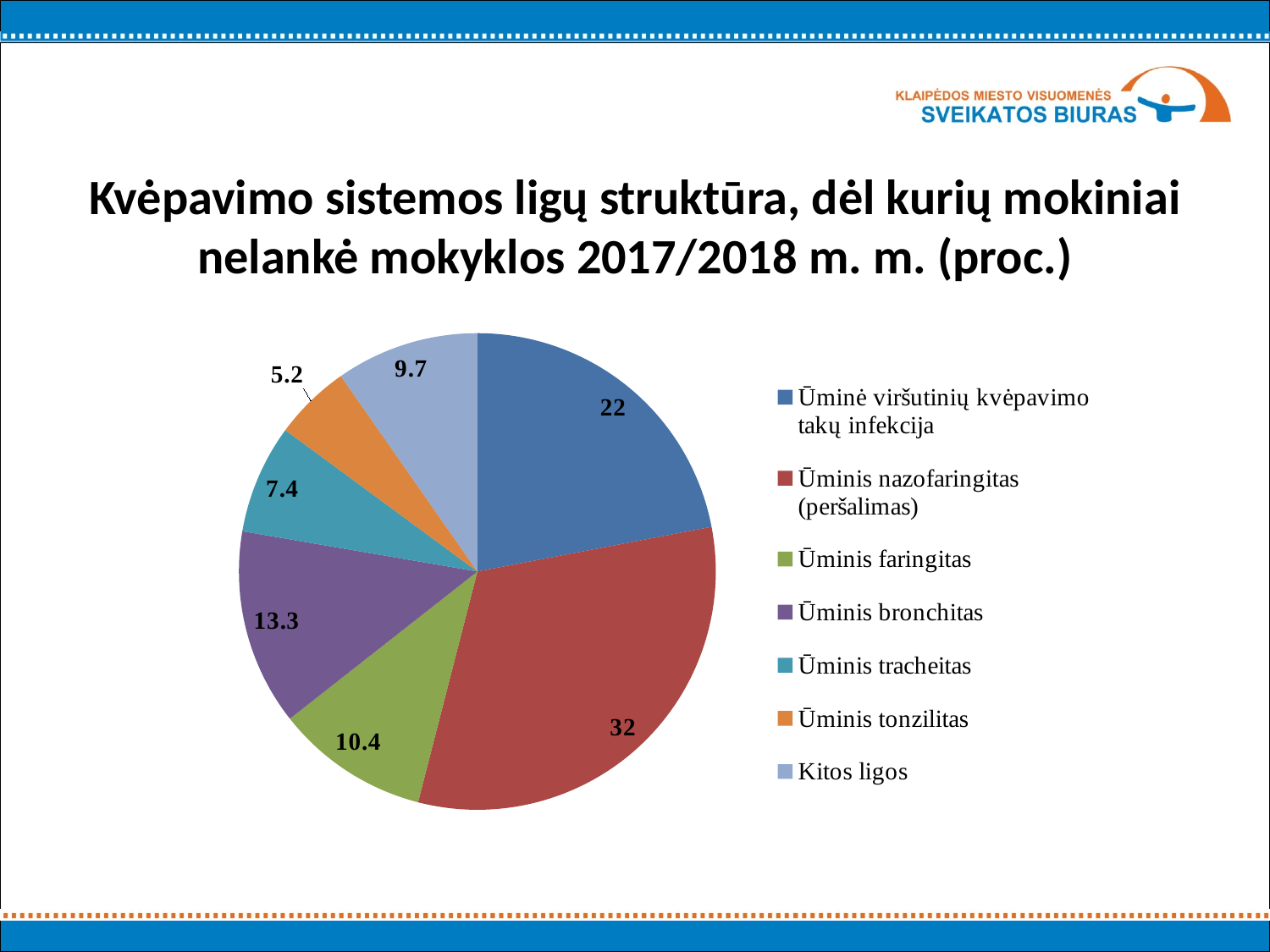
What is the value for Ūminis tonzilitas? 5.2 How many categories does the pie chart have? 7 What is the value for Ūminė viršutinių kvėpavimo takų infekcija? 22 Which is larger, the value for Ūminis bronchitas or the value for Ūminis faringitas? Ūminis bronchitas What is the value for Ūminis nazofaringitas (peršalimas)? 32 What is the value for Ūminis bronchitas? 13.3 What is the value for Kitos ligos? 9.7 Which category has the largest slice of the pie? Ūminis nazofaringitas (peršalimas) What type of chart is shown on the slide? pie chart What is the difference between the values for Ūminis nazofaringitas (peršalimas) and Ūminė viršutinių kvėpavimo takų infekcija? 10 Which category has the smallest slice of the pie? Ūminis tonzilitas What share of the pie does Ūminis tracheitas represent? 7.4